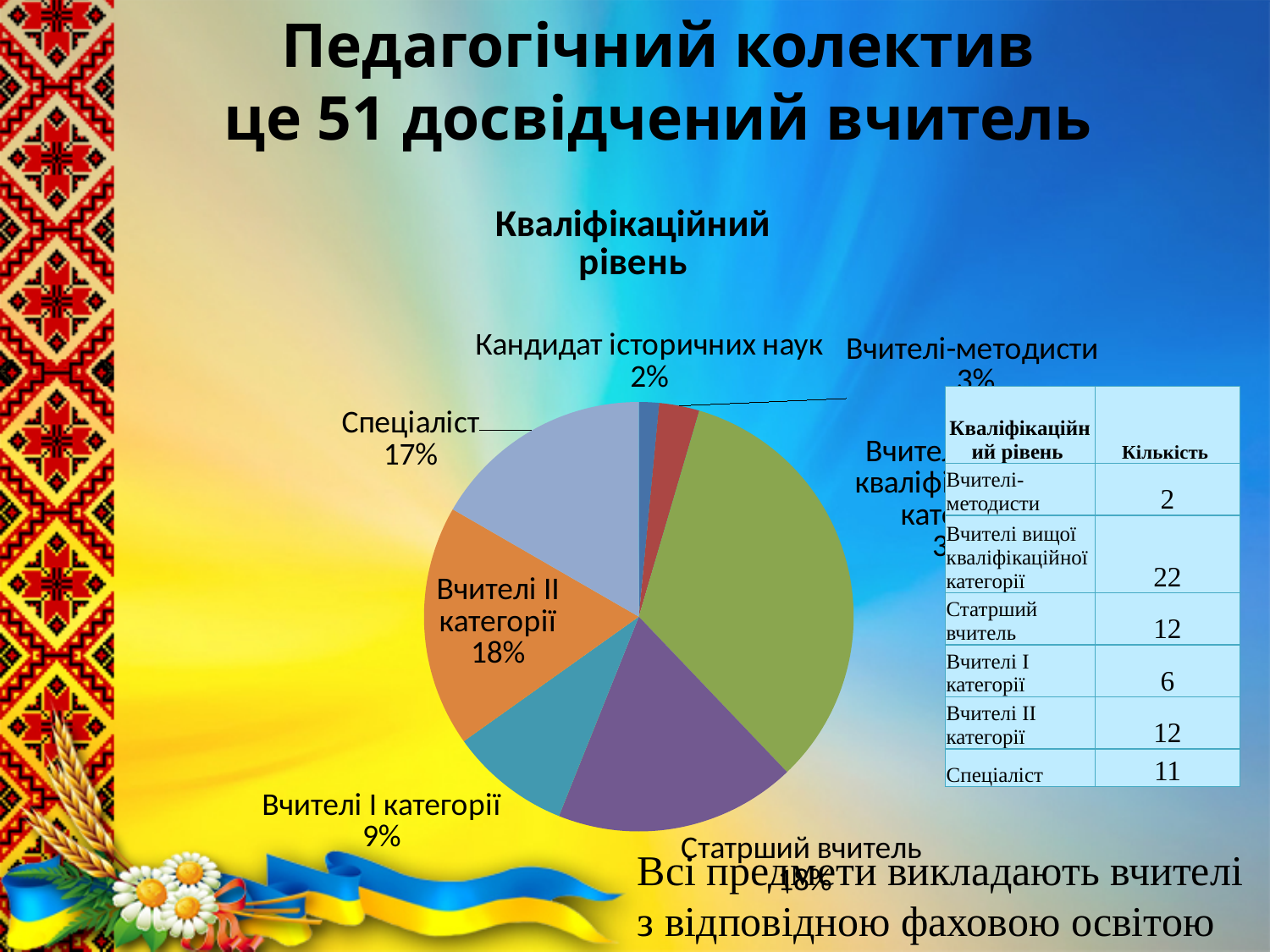
What share of the pie is labelled for Спеціаліст? 17% Which slice is larger: Вчителі ІІ категорії or Вчителі І категорії? Вчителі ІІ категорії What share of the pie is labelled for Вчителі ІІ категорії? 18% How many slices does the pie chart have? 7 What is the title of the chart? Кваліфікаційний рівень What share of the pie is labelled for Вчителі-методисти? 3% What kind of chart is shown on the slide? pie chart Which category has the largest slice of the pie? Вчителі вищої кваліфікаційної категорії What share of the pie is labelled for Кандидат історичних наук? 2% What is the difference in percentage points between the Вчителі ІІ категорії slice and the Вчителі І категорії slice? 9 Which category has the smallest slice of the pie? Кандидат історичних наук What share of the pie is labelled for Вчителі І категорії? 9%